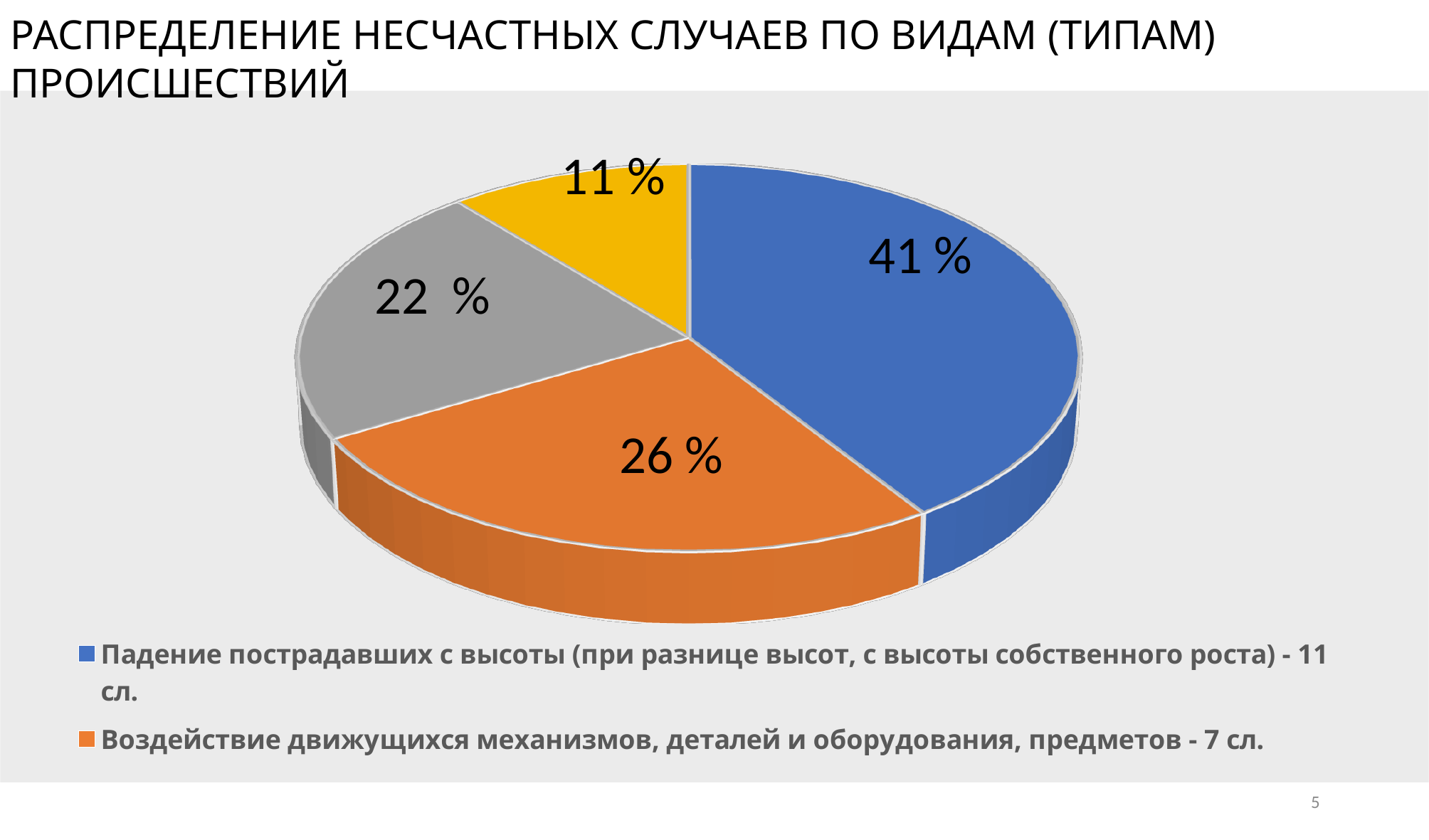
What percentage is shown on the gray slice of the pie? 22 % How many entries does the legend list? 2 What share of the pie is labelled for the orange slice (Воздействие движущихся механизмов, деталей и оборудования, предметов)? 26 % What share of the pie is labelled for the blue slice (Падение пострадавших с высоты)? 41 % What percentage is shown on the yellow slice of the pie? 11 % What kind of chart is shown on the slide? pie chart By how many percentage points does the blue slice (41 %) exceed the orange slice (26 %)? 15 Which is larger: the gray slice or the yellow slice? the gray slice Which slice of the pie is the smallest? the yellow slice (11 %) Which slice of the pie is the largest? Падение пострадавших с высоты (blue, 41 %) How many slices does the pie chart have? 4 How many cases (сл.) does the legend give for Падение пострадавших с высоты? 11 сл.